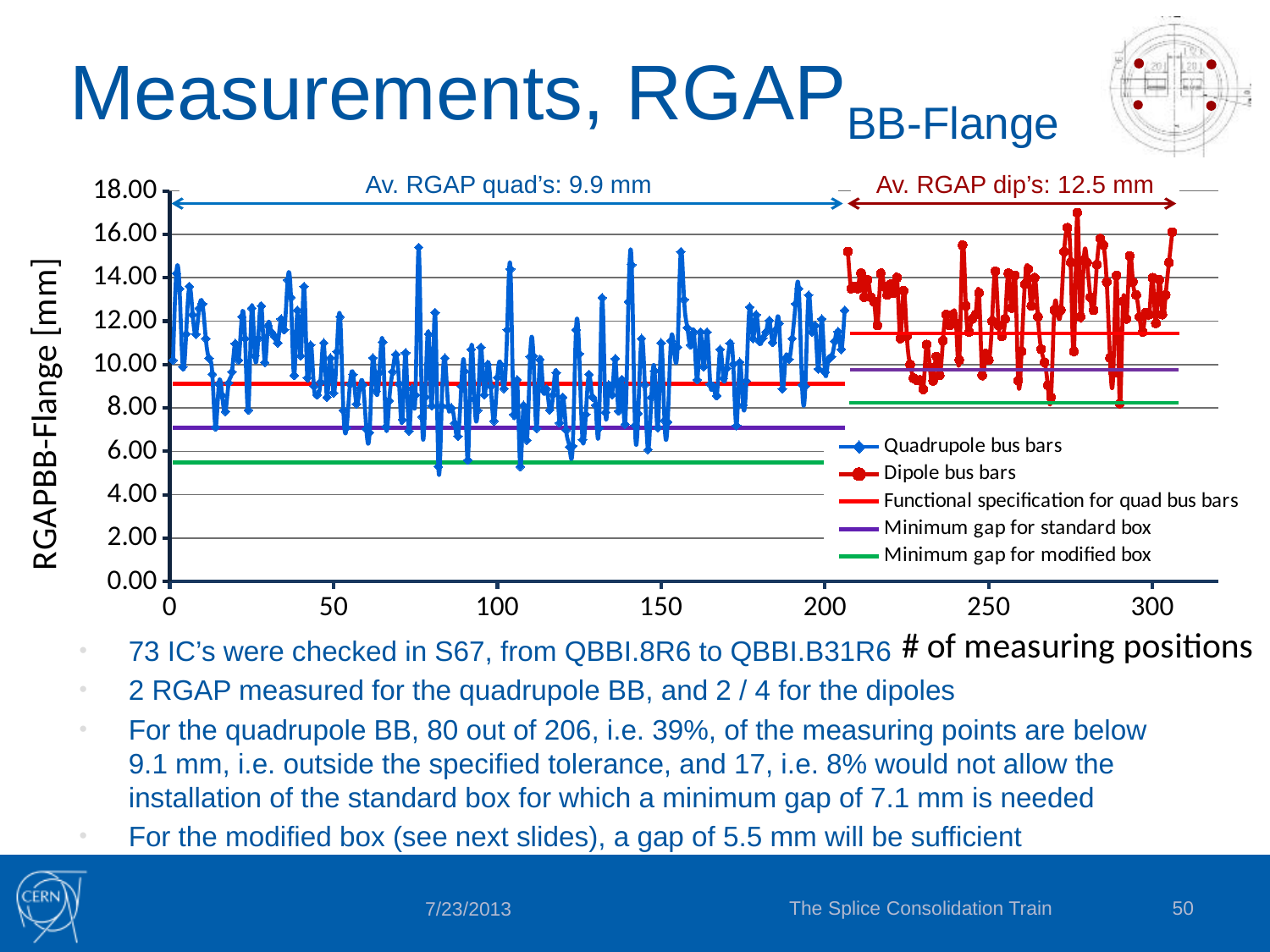
Which has the larger annotated average RGAP, the quadrupole bus bars or the dipole bus bars? Dipole bus bars What is the difference between the annotated average RGAP of the dipole bus bars and that of the quadrupole bus bars? 2.6 mm Is the 'Functional specification for quad bus bars' line greater or less than 10.00? less Is the 'Minimum gap for standard box' line greater or less than 6.00? greater What is the label of the y axis? RGAPBB-Flange [mm] Which series is plotted with red circle markers? Dipole bus bars What kind of chart is shown on the slide? line chart What is the average RGAP for the dipole bus bars, as annotated on the chart? 12.5 mm How many series does the legend list? 5 Is the 'Minimum gap for standard box' line greater or less than 8.00? less What is the average RGAP for the quadrupole bus bars, as annotated on the chart? 9.9 mm